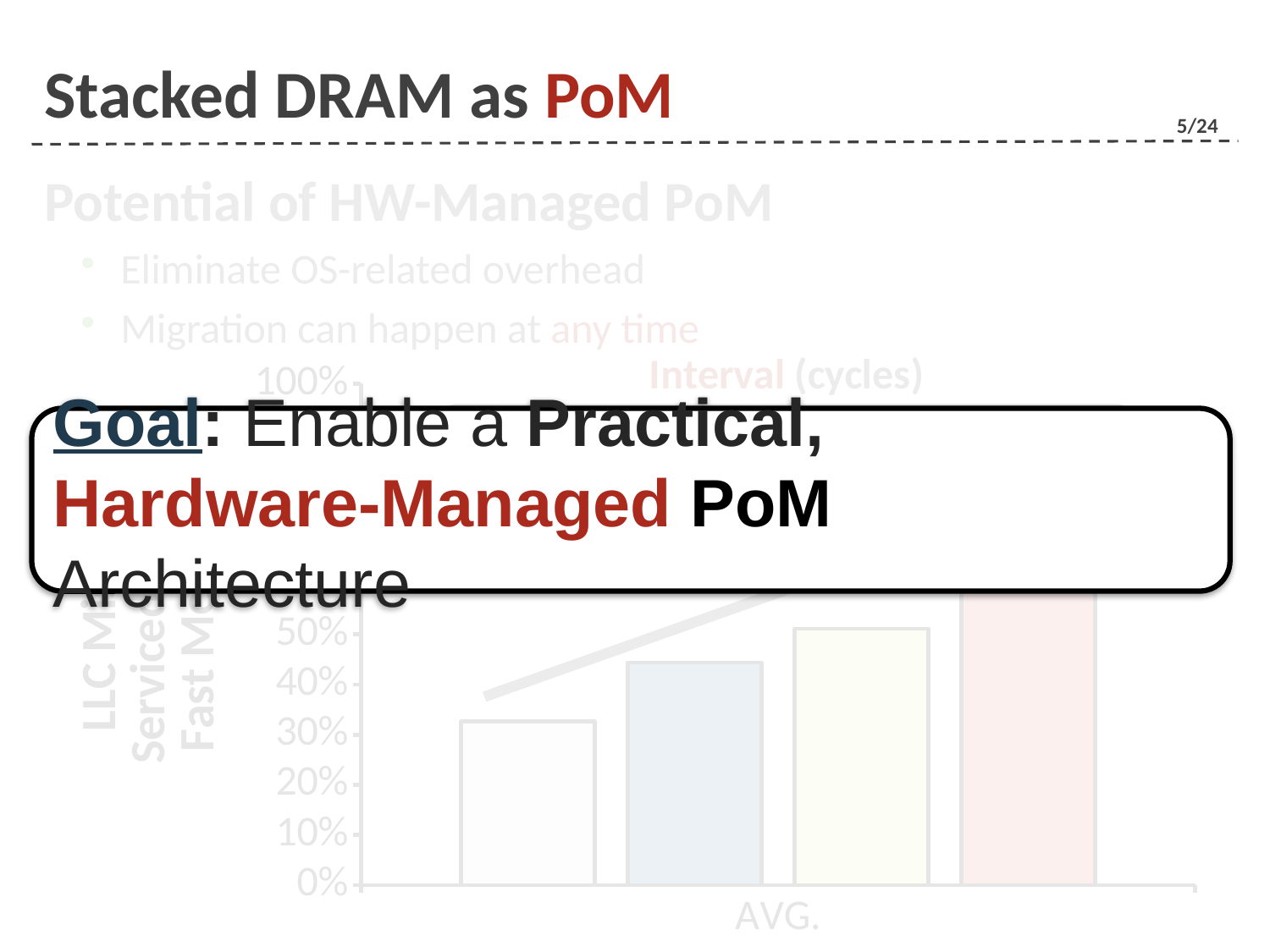
Do the bar heights rise or fall from left to right across the chart? rise Which bar is the shortest in the chart, counting from the left? the first (leftmost) bar Is the value of the second bar from the left greater or less than 50%? less What is the category label shown on the x axis of the chart? AVG. How many bars are plotted in the chart? 4 Is the value of the rightmost bar greater or less than 50%? greater What is the title printed above the chart? Interval (cycles) Which bar is the tallest in the chart, counting from the left? the fourth (rightmost) bar What kind of chart is shown on the slide? bar chart Which is larger, the second bar from the left or the third bar from the left? the third bar from the left Is the value of the leftmost bar greater or less than 40%? less